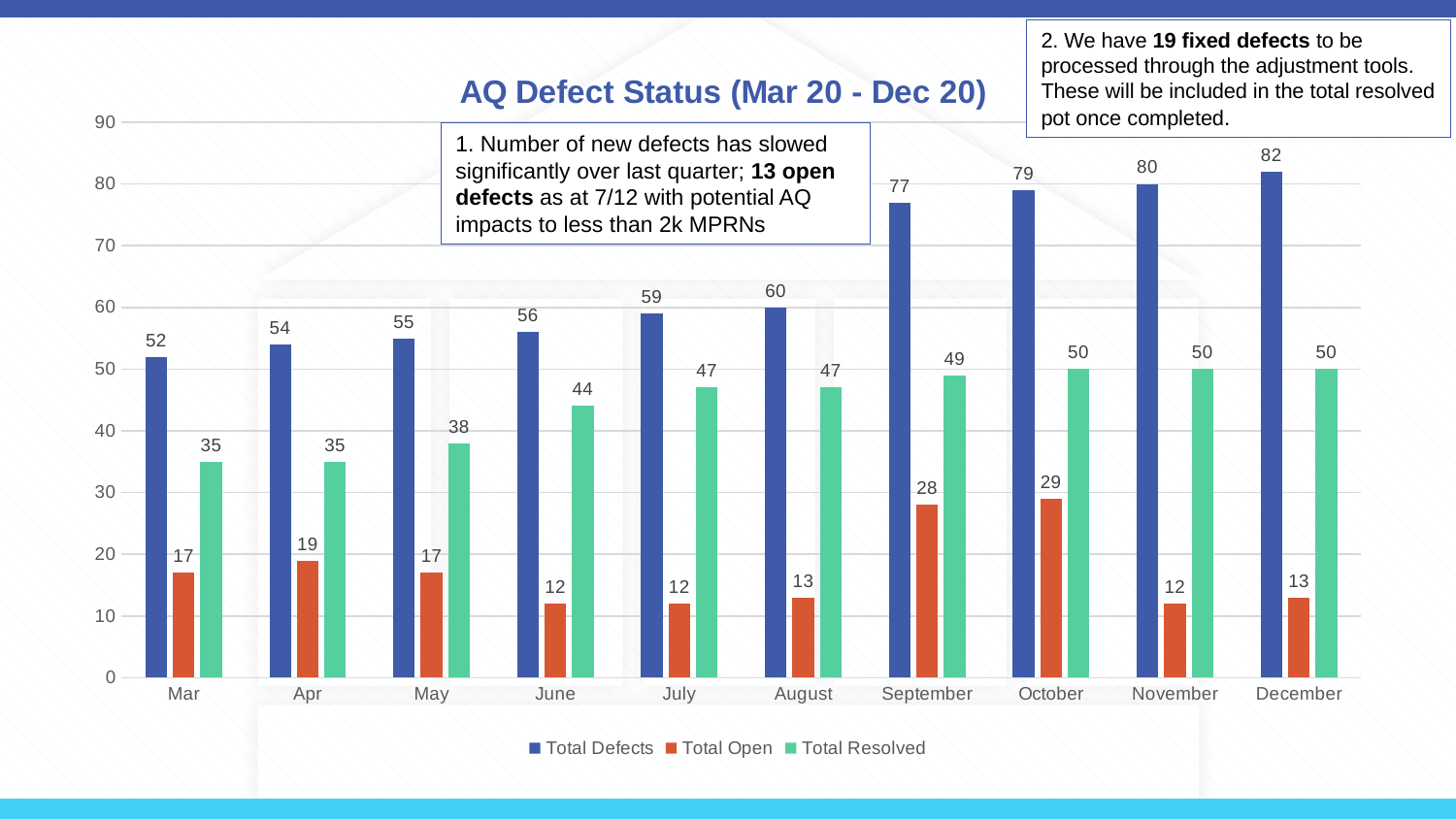
Which month has the highest Total Defects value? December How many months are shown on the x axis? 10 What is the Total Defects value for September? 77 Do the Total Defects values rise or fall from Mar to December? Rise What is the Total Resolved value for June? 44 What kind of chart is shown on the slide? Bar chart What is the Total Open value for October? 29 Is the Total Defects value for August greater or less than 70? less How many series does the legend list? 3 Which is larger, Total Open in September or Total Open in November? Total Open in September Which month has the lowest Total Resolved value? Mar and Apr (both 35) What is the difference between Total Defects and Total Resolved in December? 32